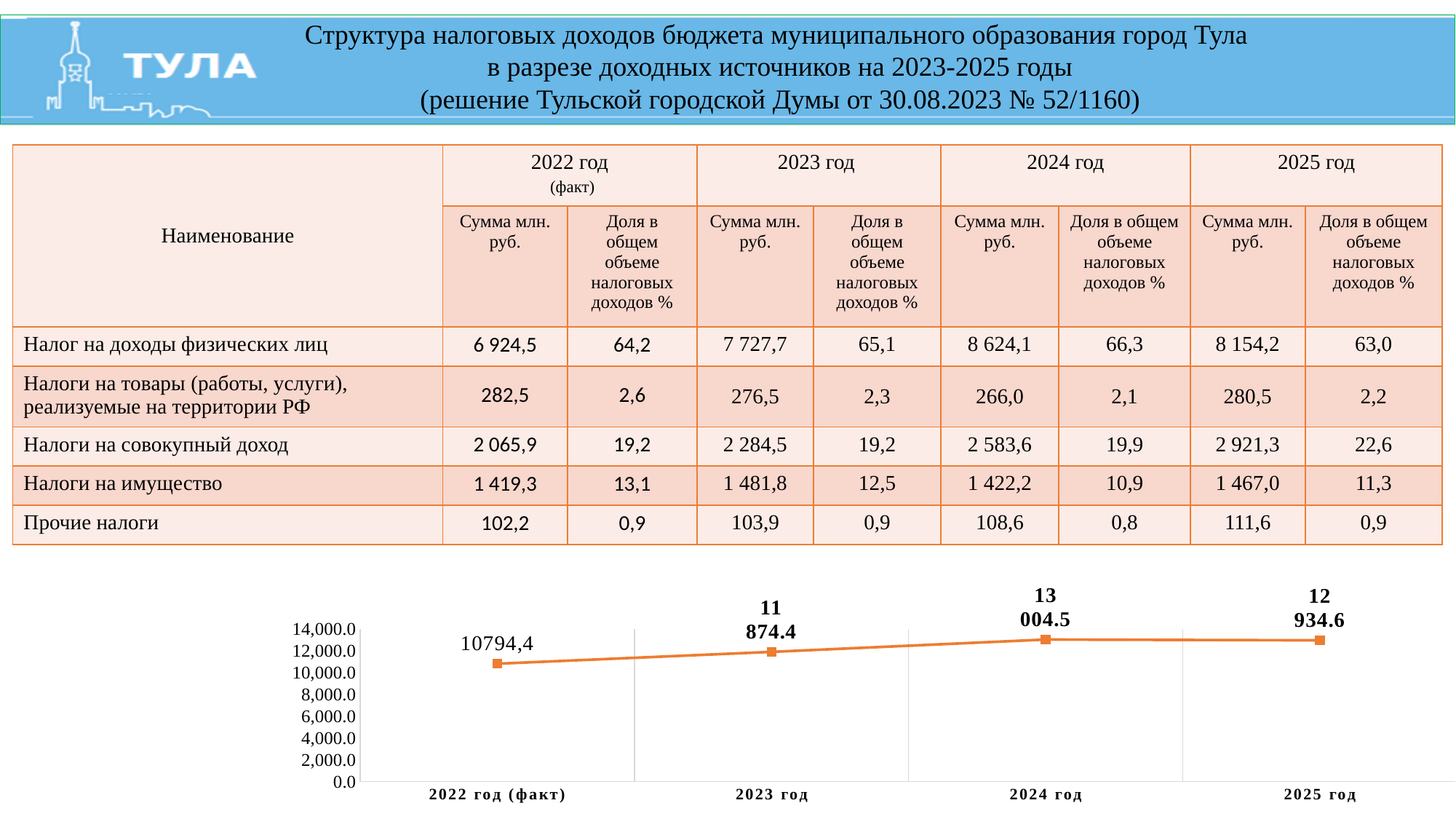
What is the value plotted for 2023 год on the line chart? 11 874.4 On the line chart, is the value for 2022 год (факт) greater or less than 12,000.0? less What is the value plotted for 2025 год on the line chart? 12 934.6 On the line chart, what is the difference between the values for 2024 год and 2025 год? 69.9 What is the value plotted for 2024 год on the line chart? 13 004.5 What kind of chart is shown at the bottom of the slide? line chart What is the highest tick value shown on the vertical axis of the line chart? 14,000.0 On the line chart, do the values rise or fall from 2022 год (факт) to 2024 год? rise What is the value plotted for 2022 год (факт) on the line chart? 10794,4 How many data points are plotted on the line chart? 4 Which year has the lowest value on the line chart? 2022 год (факт) Which year has the highest value on the line chart? 2024 год